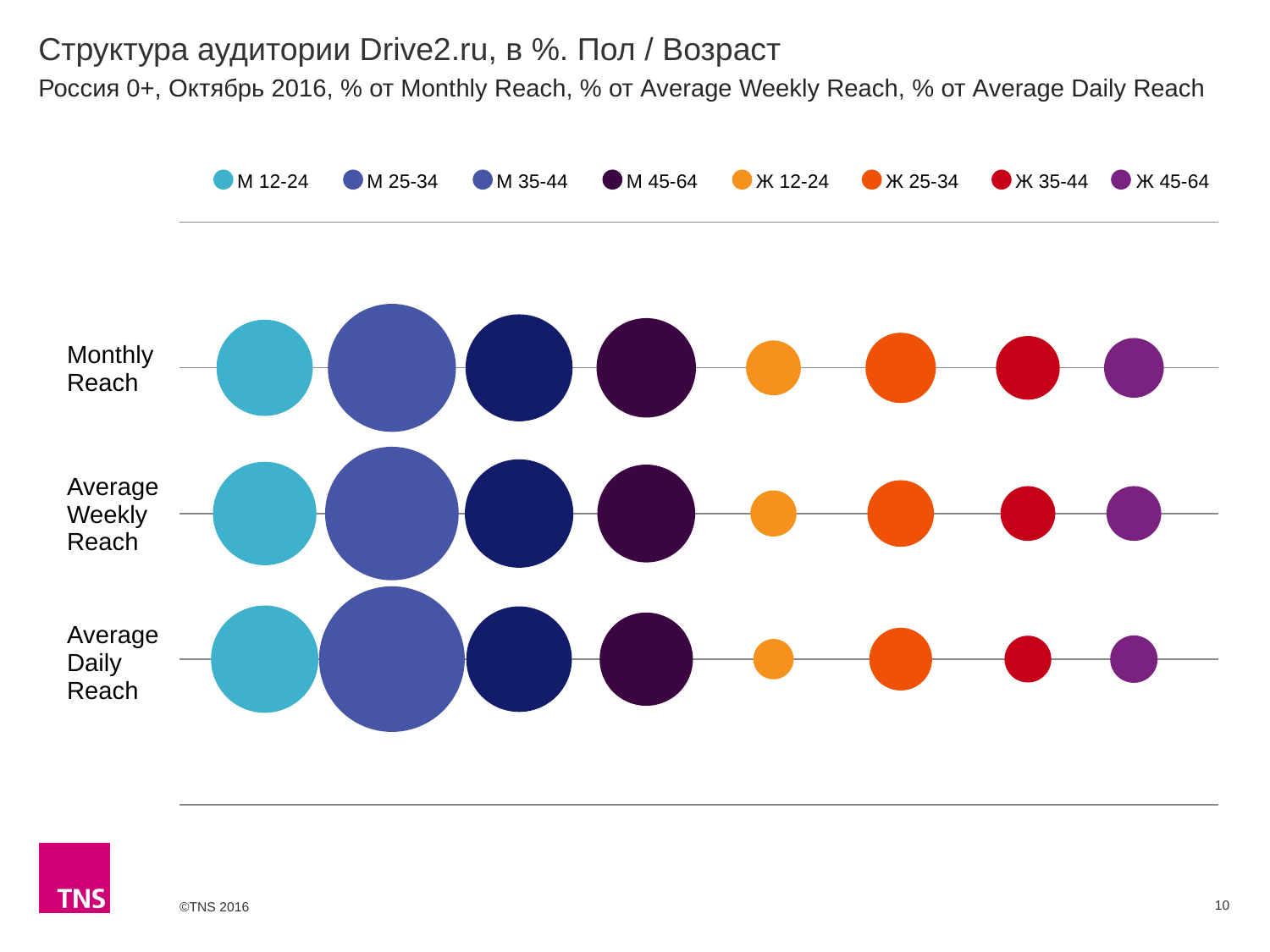
In the Average Daily Reach row, which bubble is larger: М 12-24 or Ж 35-44? М 12-24 In the Average Weekly Reach row, which bubble is larger: М 25-34 or М 45-64? М 25-34 Which gender/age group has the largest bubble in the Average Daily Reach row? М 25-34 In the Monthly Reach row, which bubble is larger: Ж 25-34 or Ж 12-24? Ж 25-34 How many series does the legend list? 8 Which gender/age group has the largest bubble in the Monthly Reach row? М 25-34 How many reach categories (rows) are plotted on the chart? 3 Which gender/age group has the largest bubble in the Average Weekly Reach row? М 25-34 What kind of chart is shown on the slide? bubble chart What is the first entry in the chart legend? М 12-24 What is the title of the chart on the slide? Структура аудитории Drive2.ru, в %. Пол / Возраст